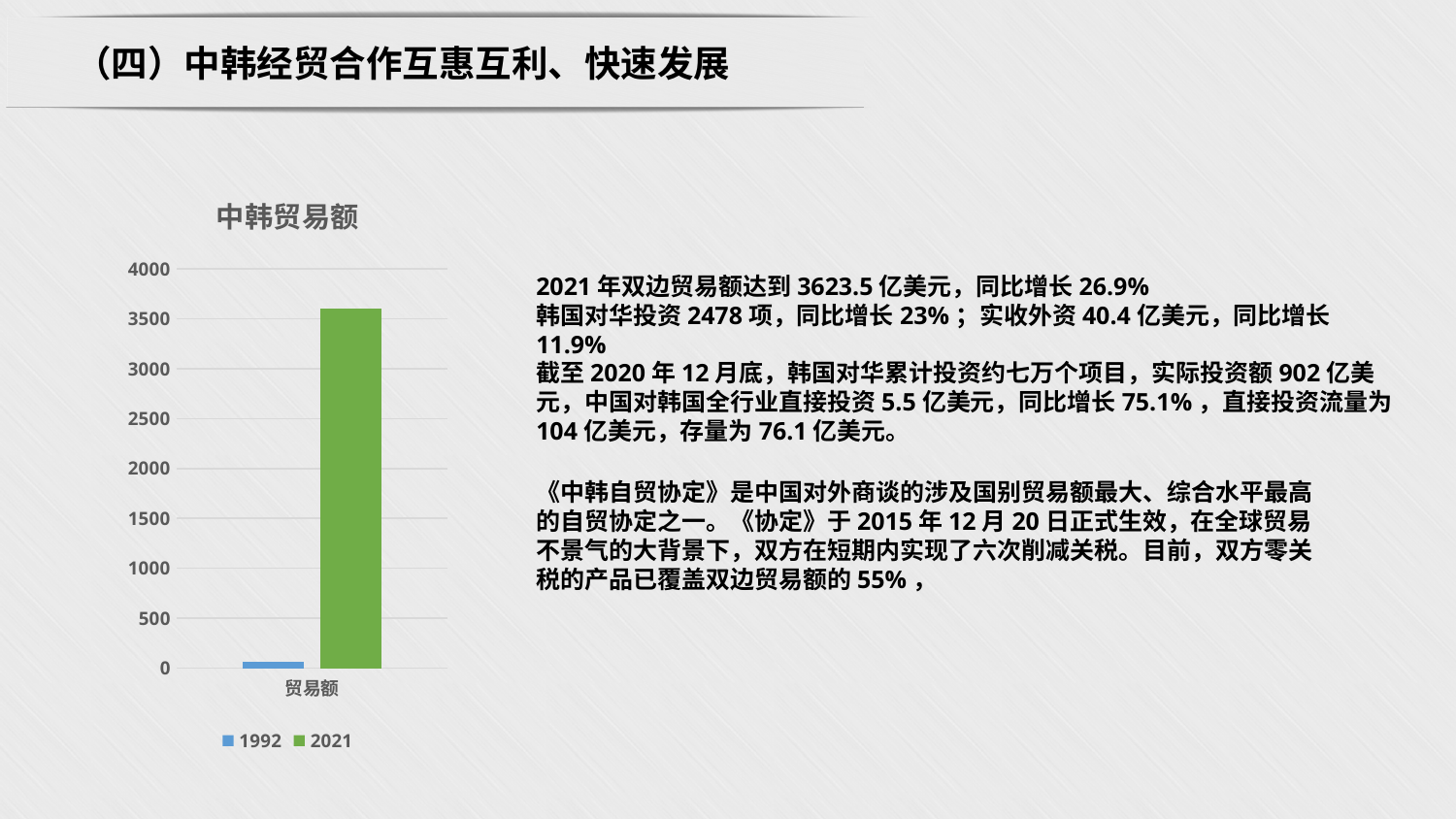
Is the value for 2021 greater or less than 3000? greater Is the value for 1992 greater or less than 500? less What is the title of the chart? 中韩贸易额 Which colour represents the 2021 series in the chart? green Which series has the highest value in the chart? 2021 Which series has the higher value for 贸易额, 1992 or 2021? 2021 Is the value for 2021 greater or less than 4000? less Which series has the lowest value in the chart? 1992 How many categories are shown on the x axis of the chart? 1 What is the label of the category on the x axis? 贸易额 What kind of chart is shown on the slide? bar chart How many series does the chart legend list? 2